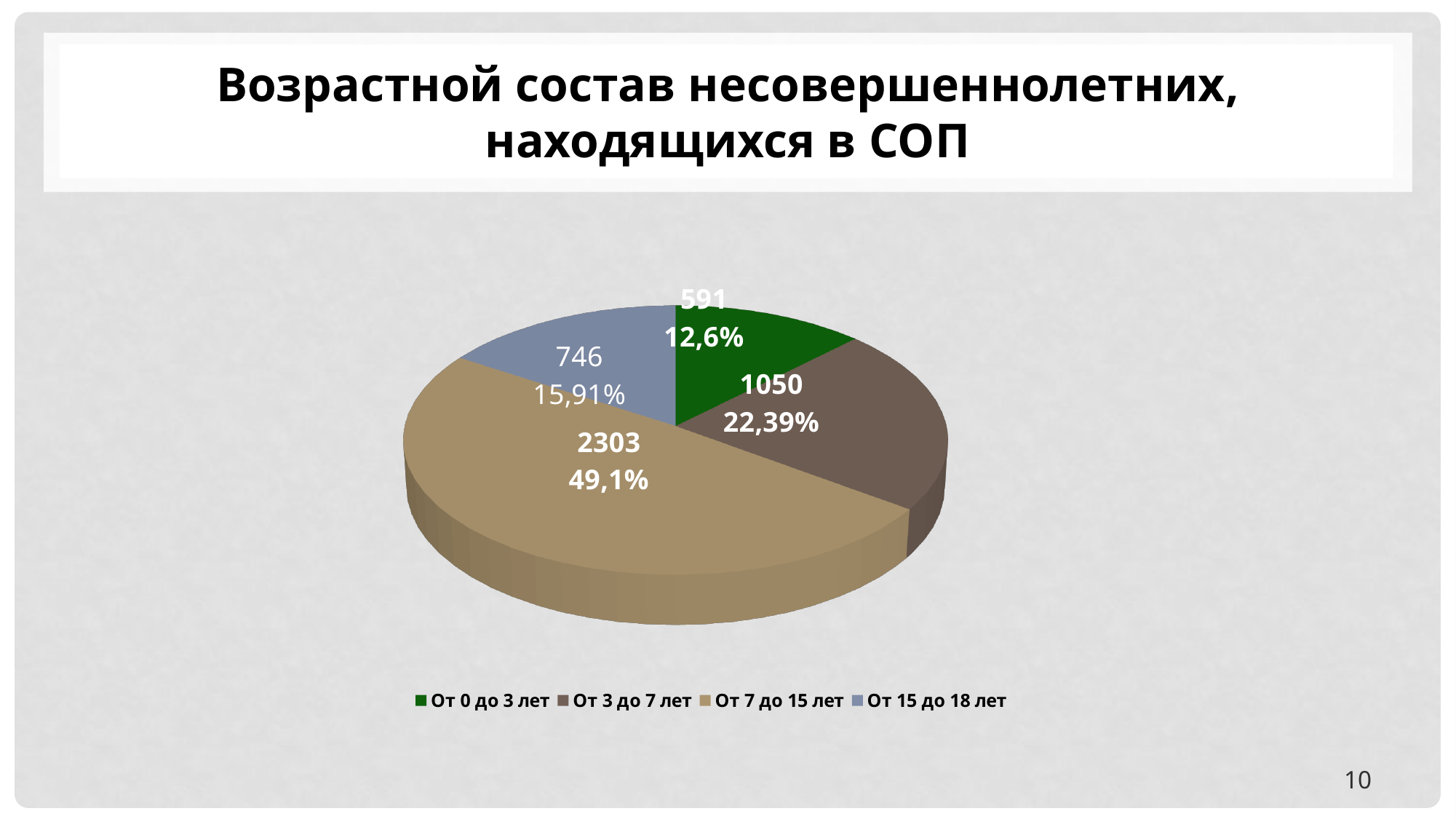
Which age group has the largest slice? От 7 до 15 лет What percentage is shown for the 'От 7 до 15 лет' slice? 49,1% Which age group has the smallest slice? От 0 до 3 лет What is the value for the 'От 7 до 15 лет' slice? 2303 What is the value for the 'От 15 до 18 лет' slice? 746 What is the value for the 'От 0 до 3 лет' slice? 591 Which is larger, the value for 'От 15 до 18 лет' or 'От 3 до 7 лет'? От 3 до 7 лет How many slices does the pie chart have? 4 What kind of chart is shown on the slide? Pie chart What is the difference between the values for 'От 3 до 7 лет' and 'От 0 до 3 лет'? 459 What percentage is shown for the 'От 3 до 7 лет' slice? 22,39% What colour is the 'От 0 до 3 лет' slice? Green